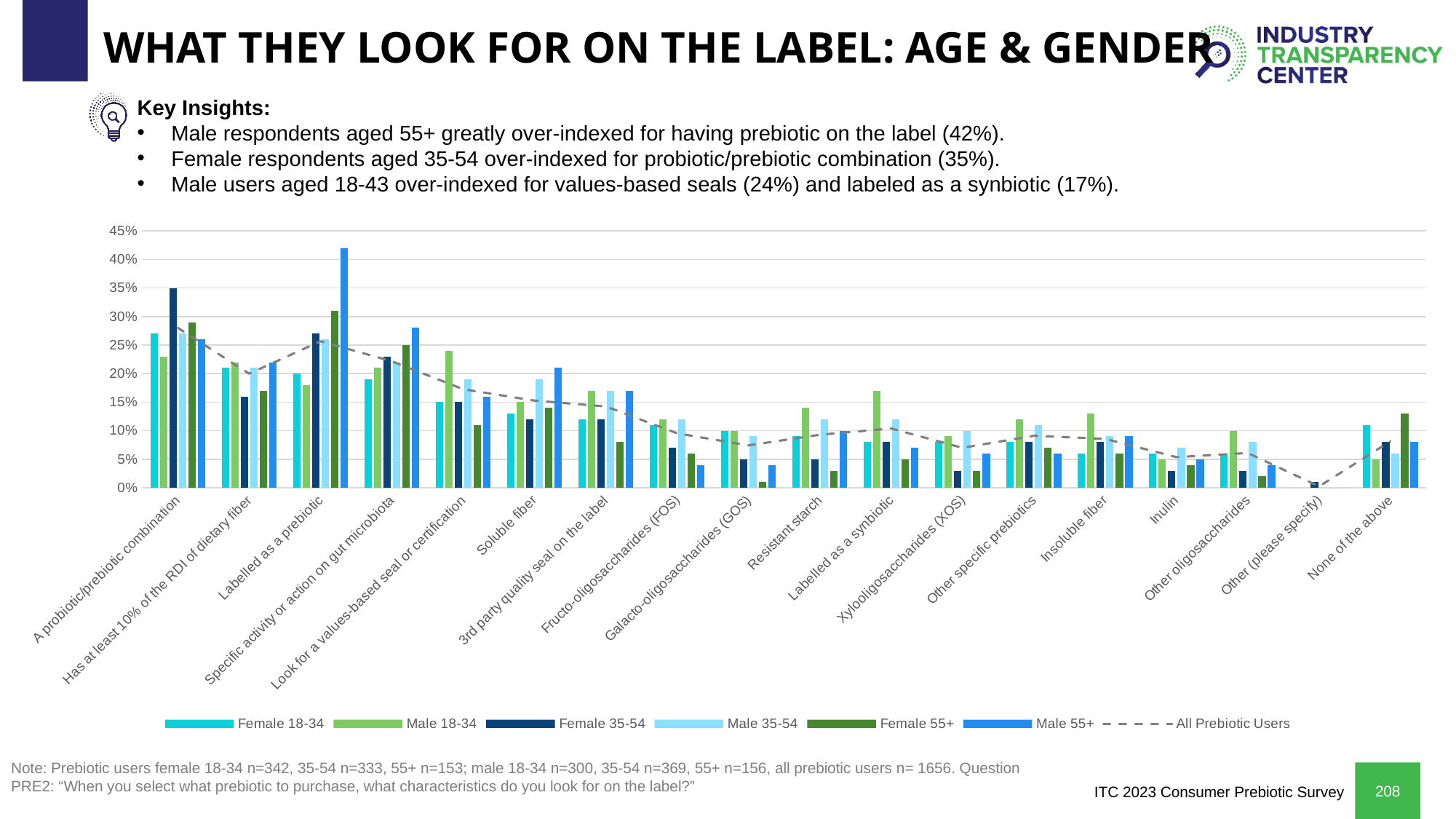
What kind of chart is shown on the slide? combination bar and line chart For 'Look for a values-based seal or certification', which is larger: the Male 18-34 bar or the Female 18-34 bar? Male 18-34 How many series does the chart legend list? 7 Is the Female 35-54 value for 'A probiotic/prebiotic combination' greater or less than 30%? greater Which category has the highest Female 35-54 value? A probiotic/prebiotic combination What does the dashed grey line in the chart represent? All Prebiotic Users Is the Female 55+ value for 'Galacto-oligosaccharides (GOS)' greater or less than 5%? less Is the Male 55+ value for 'Labelled as a prebiotic' greater or less than 40%? greater How many categories are shown along the x axis of the chart? 18 Which series has the highest bar for 'Resistant starch'? Male 18-34 Which series has the highest bar for 'Labelled as a prebiotic'? Male 55+ Does the 'All Prebiotic Users' dashed line generally rise or fall from 'A probiotic/prebiotic combination' to 'Other (please specify)'? fall